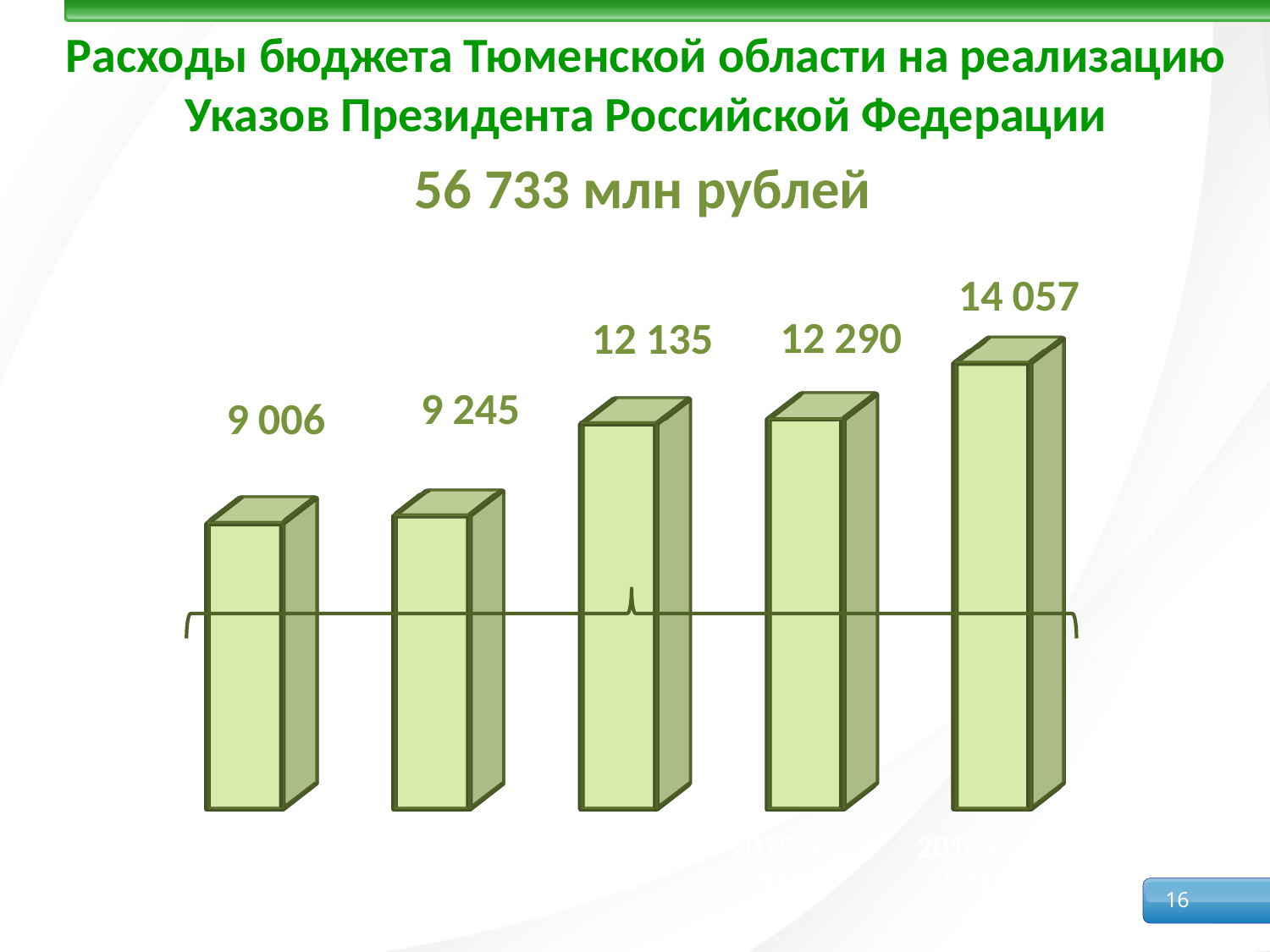
How many bars are plotted in the chart? 5 Which bar has the lowest value? The leftmost bar (9 006) What is the value shown on the middle (third) bar? 12 135 Do the bar values rise or fall from left to right? Rise What is the value shown on the second bar from the left? 9 245 Which is larger: the value of the third bar or the value of the fourth bar? The fourth bar (12 290) What is the value shown on the fourth bar from the left? 12 290 What is the value shown on the last (rightmost) bar? 14 057 What is the value shown on the first (leftmost) bar? 9 006 What kind of chart is shown on the slide? Bar chart What is the difference between the rightmost bar (14 057) and the leftmost bar (9 006)? 5 051 Which bar has the highest value? The rightmost bar (14 057)